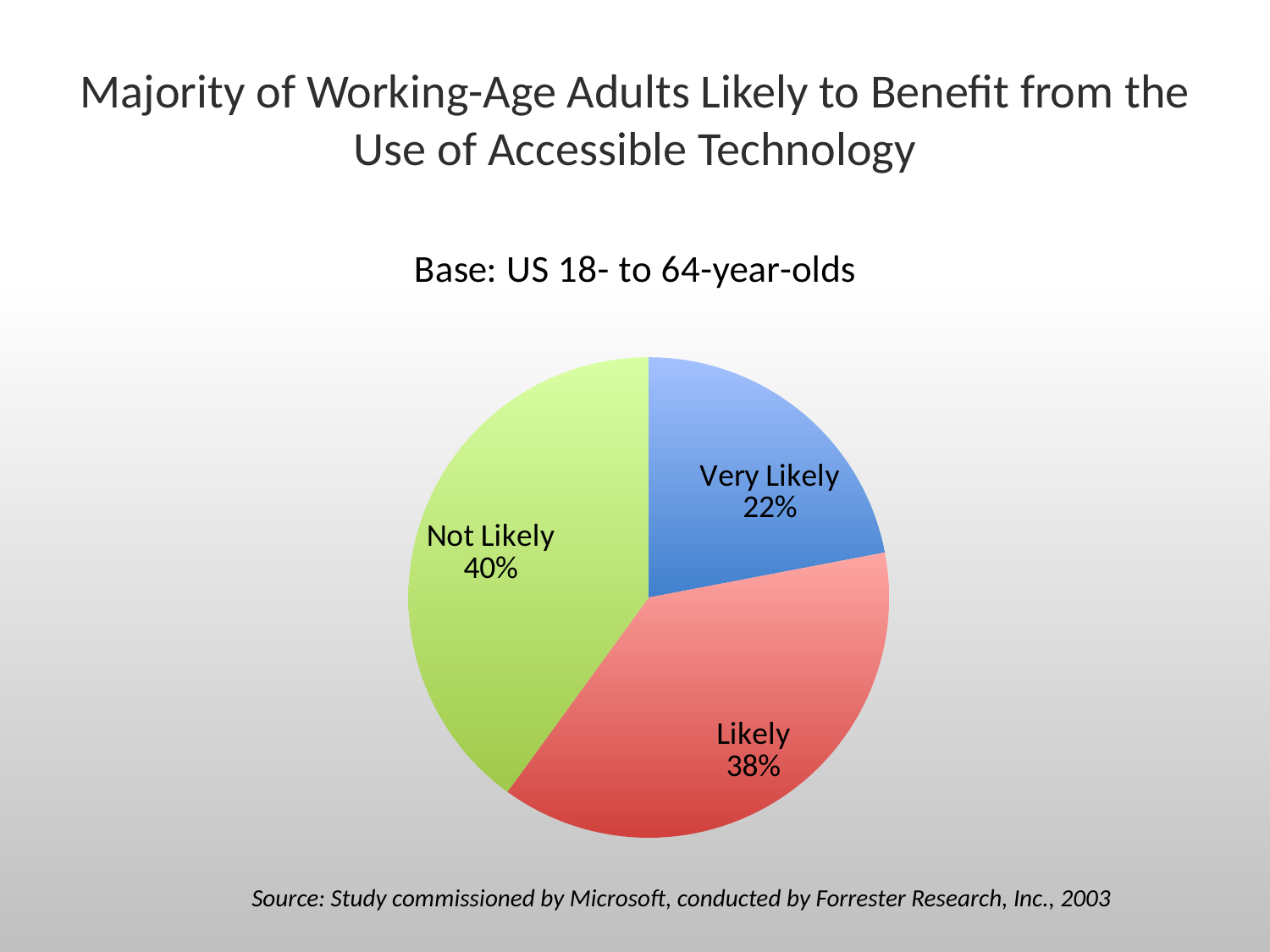
How many slices does the pie chart have? 3 What is the difference in percentage points between the "Not Likely" and "Very Likely" slices? 18 What percentage of the pie is labelled "Likely"? 38% What base population is stated above the chart? US 18- to 64-year-olds What kind of chart is shown on the slide? Pie chart Which slice is larger, "Likely" or "Very Likely"? Likely Which slice of the pie is the smallest? Very Likely What is the combined percentage of the "Very Likely" and "Likely" slices? 60% What percentage of the pie is labelled "Very Likely"? 22% Which slice of the pie is the largest? Not Likely What percentage of the pie is labelled "Not Likely"? 40% What is the difference in percentage points between the "Likely" and "Very Likely" slices? 16